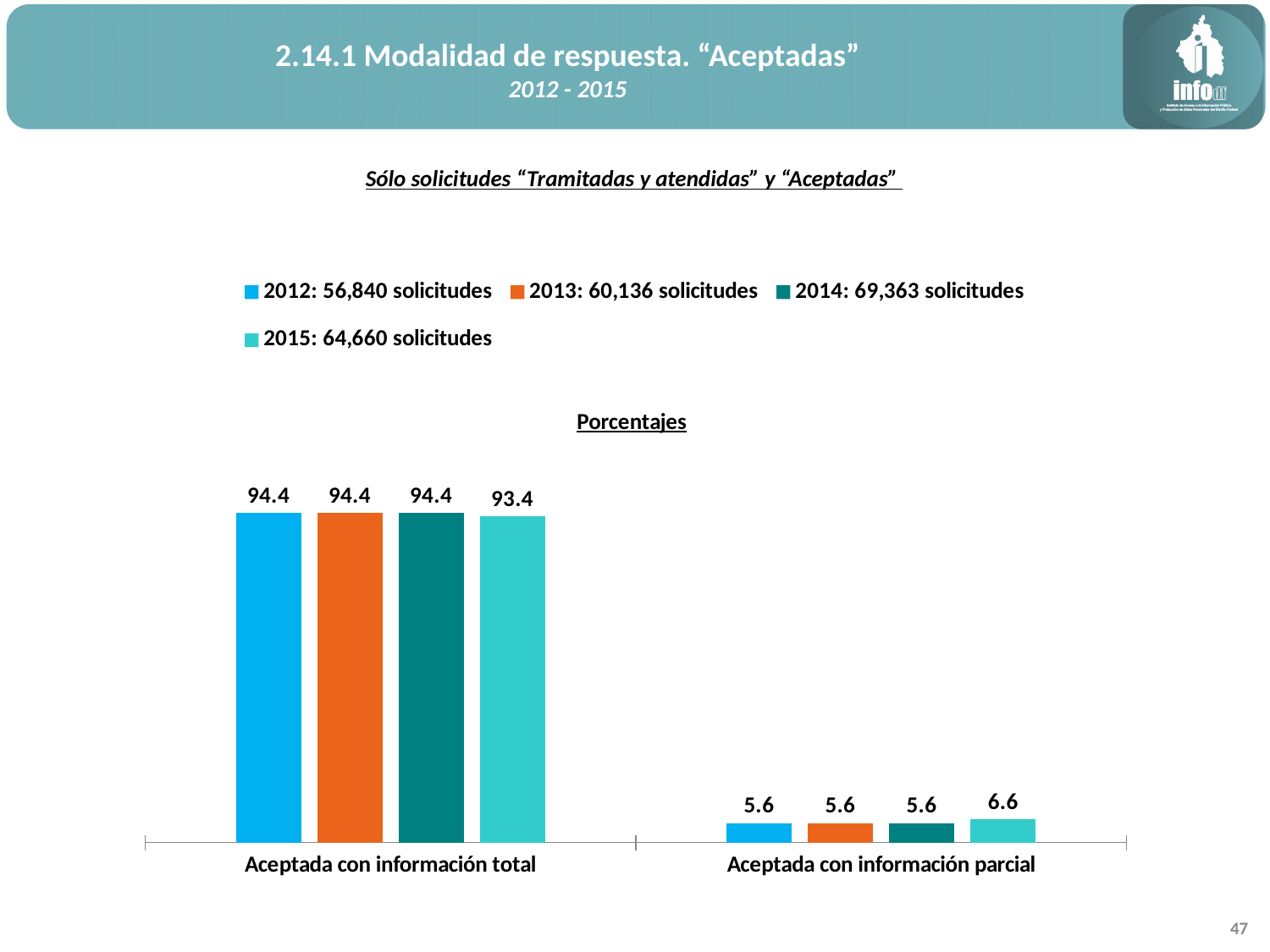
How many categories are shown on the x axis? 2 Which is larger: the 2015 value for "Aceptada con información parcial" or the 2014 value for "Aceptada con información parcial"? 2015 What is the value for 2013 in the "Aceptada con información total" category? 94.4 According to the legend, how many solicitudes were there in 2014? 69,363 What is the value for 2015 in the "Aceptada con información total" category? 93.4 What is the difference between the 2014 and 2015 values in the "Aceptada con información total" category? 1.0 What is the value for 2015 in the "Aceptada con información parcial" category? 6.6 What kind of chart is shown on the slide? Bar chart Which year has the lowest value in the "Aceptada con información total" category? 2015 How many series does the legend list? 4 Which year has the highest value in the "Aceptada con información parcial" category? 2015 What is the value for 2012 in the "Aceptada con información parcial" category? 5.6